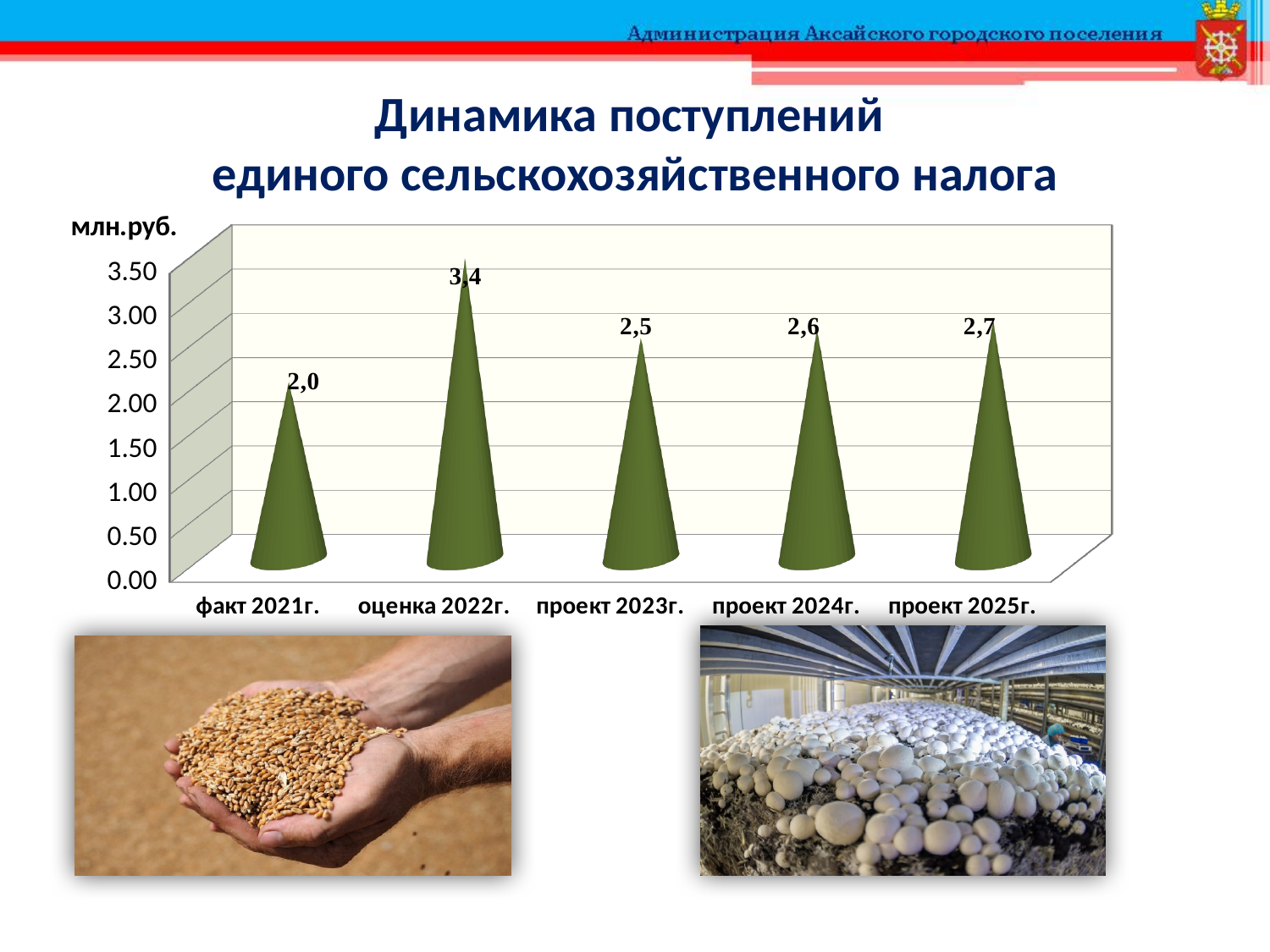
What is the difference between the values for оценка 2022г. and факт 2021г.? 1,4 What unit is shown on the vertical axis of the chart? млн.руб. Is the value for оценка 2022г. greater or less than 3.00? greater How many categories are shown on the x axis? 5 What is the value for факт 2021г.? 2,0 Which is larger, the value for проект 2024г. or the value for факт 2021г.? проект 2024г. Which category has the highest value? оценка 2022г. What is the value for проект 2025г.? 2,7 Which category has the lowest value? факт 2021г. What is the difference between the values for проект 2025г. and проект 2023г.? 0,2 What is the value for оценка 2022г.? 3,4 What kind of chart is shown on the slide? bar chart